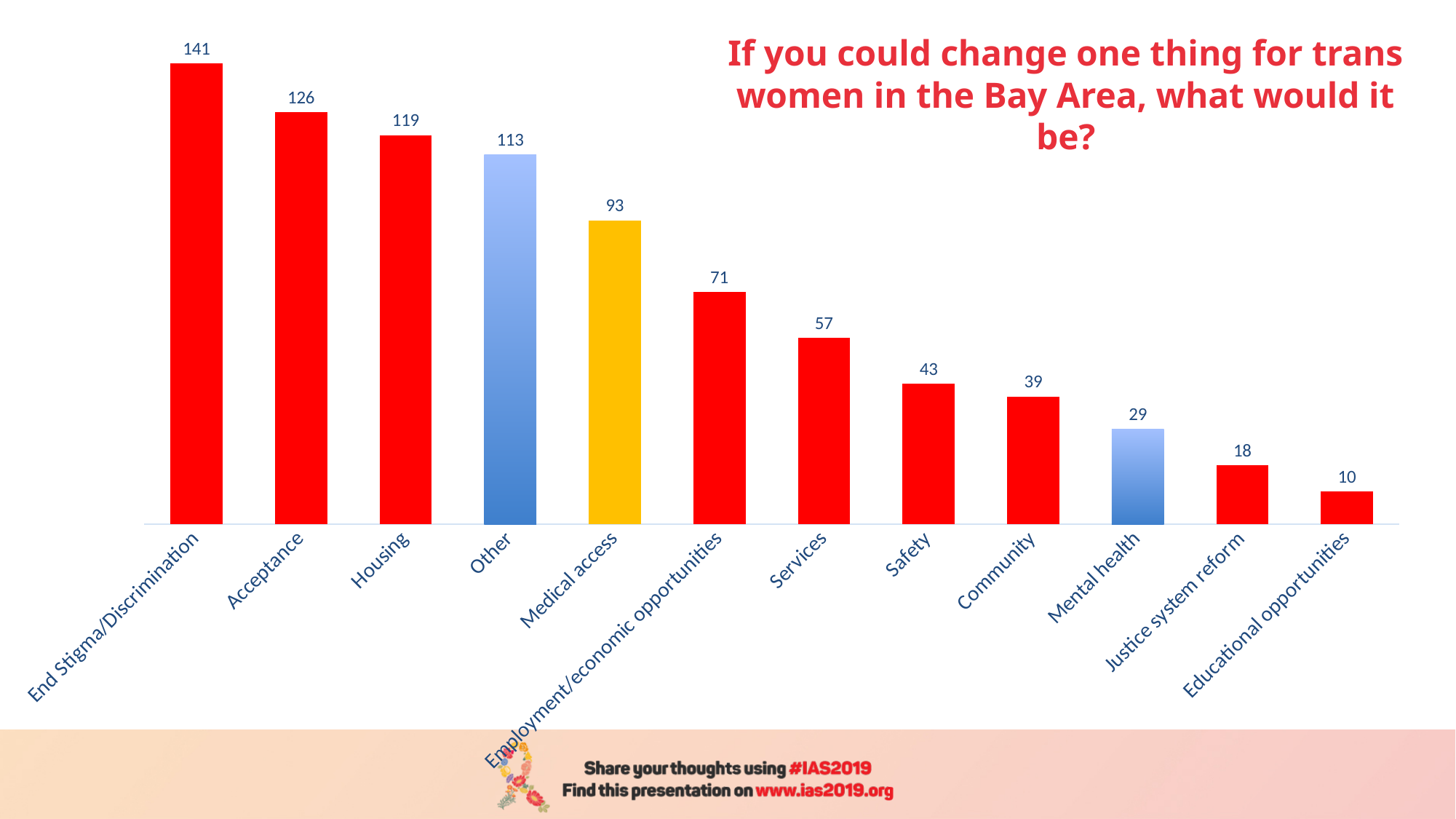
Do the values rise or fall from left to right along the x axis? Fall Which category has the lowest value? Educational opportunities Which is larger, the value for Safety or the value for Community? Safety What is the title of the chart? If you could change one thing for trans women in the Bay Area, what would it be? What is the difference between the values for Acceptance and Services? 69 What kind of chart is this? Bar chart Which category has the highest value? End Stigma/Discrimination How many categories are shown in the chart? 12 What is the value for Mental health? 29 What colour is the bar for Medical access? Yellow What is the value for Medical access? 93 What is the value for Housing? 119